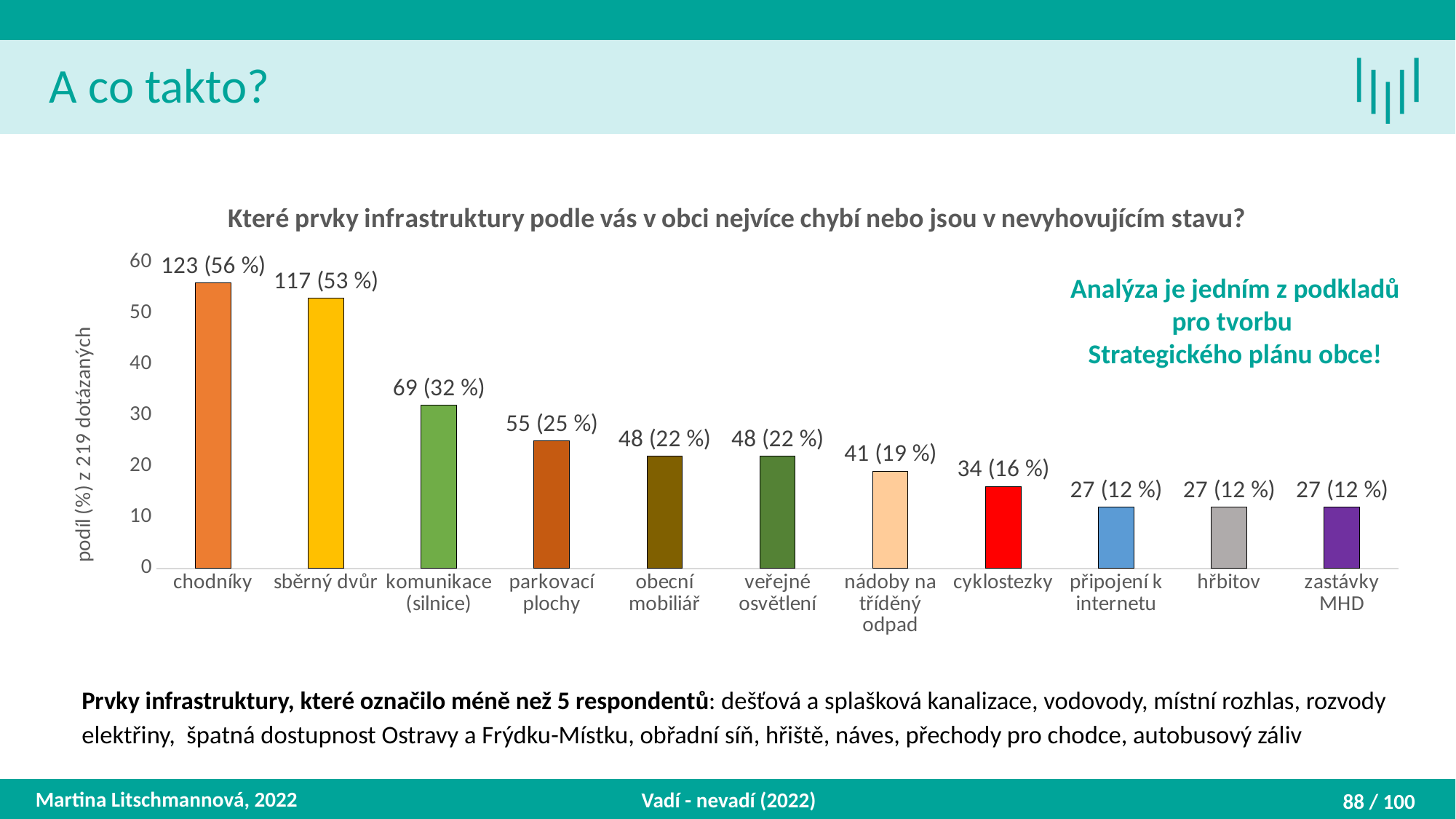
What is the difference in respondent counts between chodníky (123) and sběrný dvůr (117)? 6 What is the data label shown for nádoby na tříděný odpad? 41 (19 %) What is the label of the vertical axis? podíl (%) z 219 dotázaných What is the data label shown for chodníky? 123 (56 %) How many categories are shown on the x axis? 11 Do the values generally rise or fall from left to right along the x axis? fall Which category has the highest value? chodníky What kind of chart is shown on the slide? bar chart What is the data label shown for cyklostezky? 34 (16 %) What is the data label shown for komunikace (silnice)? 69 (32 %) Which is larger, the value for parkovací plochy or the value for obecní mobiliář? parkovací plochy What is the title of the chart? Které prvky infrastruktury podle vás v obci nejvíce chybí nebo jsou v nevyhovujícím stavu?